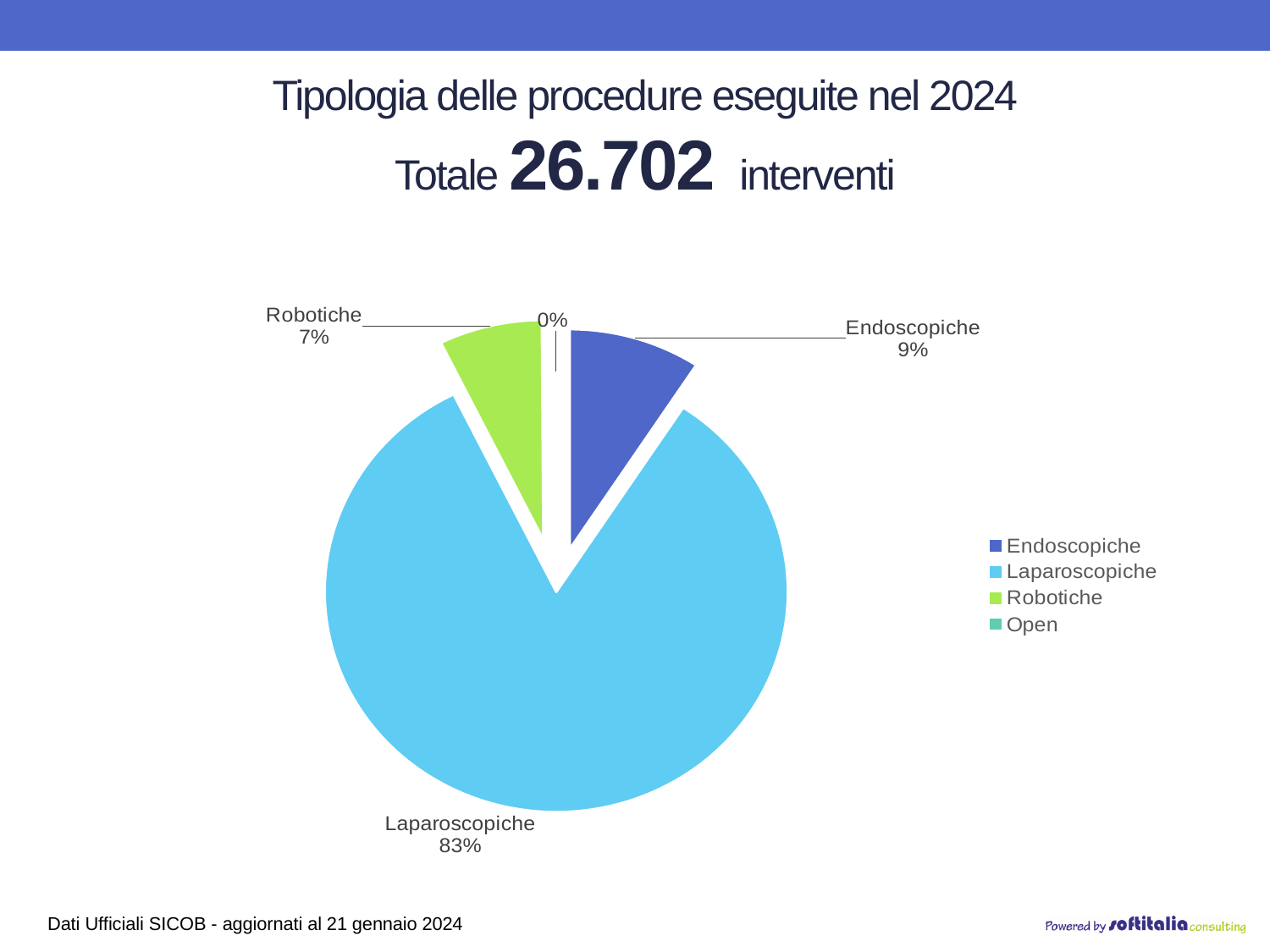
What share of the pie does Laparoscopiche account for? 83% What is the total number of interventions stated on the slide? 26.702 What is the difference in percentage points between the Laparoscopiche and Endoscopiche slices? 74 What kind of chart is shown on the slide? pie chart What percentage is shown for the Open slice? 0% What share of the pie does Endoscopiche account for? 9% What colour is the Laparoscopiche slice? light blue Which category has the largest slice of the pie? Laparoscopiche Which category has the smallest slice of the pie? Open Which is larger, the Endoscopiche slice or the Robotiche slice? Endoscopiche What share of the pie does Robotiche account for? 7% How many categories does the legend list? 4